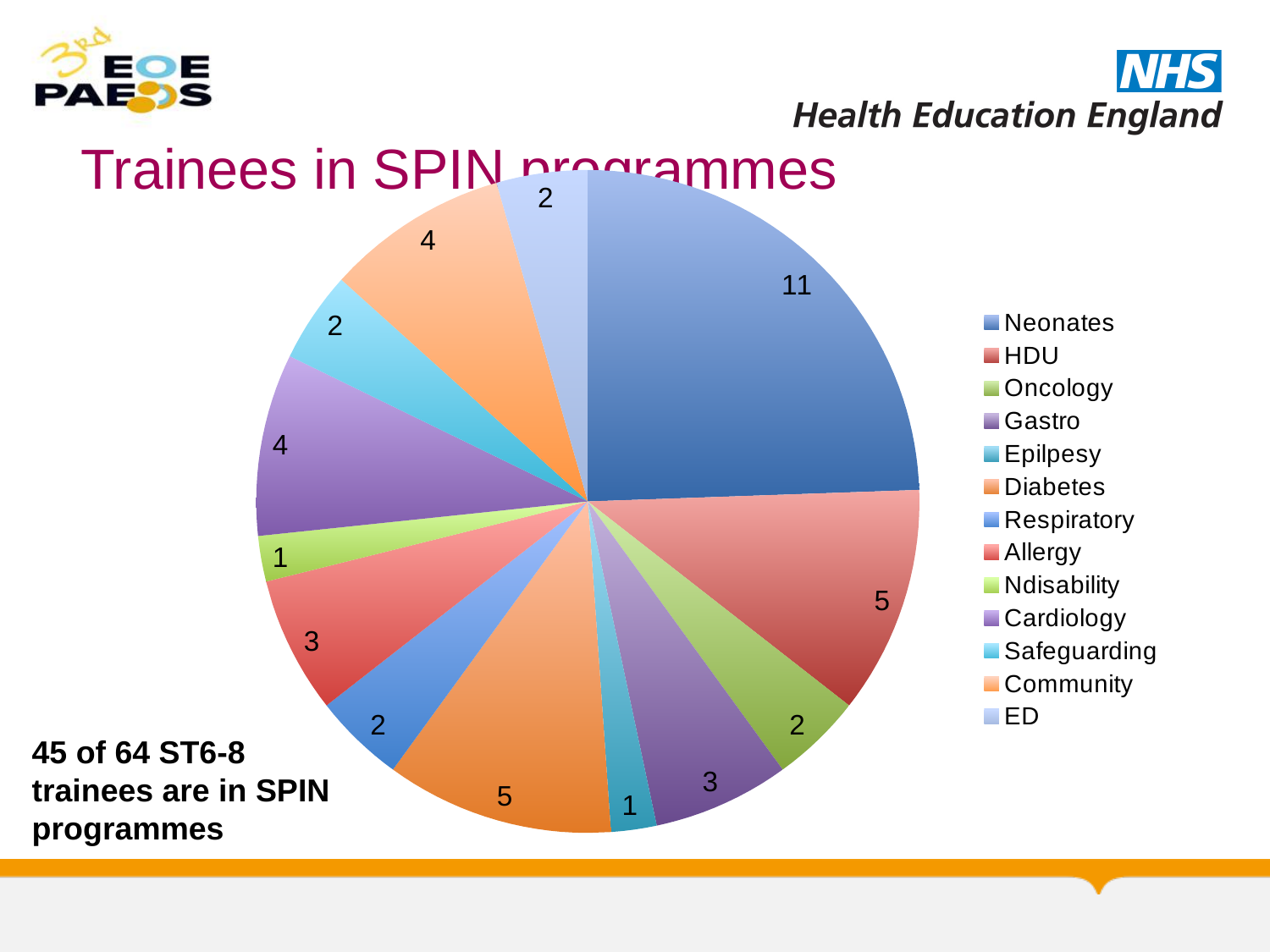
How many programmes (slices) are shown in the pie chart? 13 What type of chart is shown on the slide? pie chart What is the value shown for Epilpesy? 1 Which has more trainees, Gastro or Oncology? Gastro Which has more trainees, Community or Respiratory? Community How many trainees are in the Neonates SPIN programme? 11 What is the value shown for Cardiology? 4 What is the title of the chart? Trainees in SPIN programmes What is the total of all the slice values in the pie chart? 45 What is the difference between the Neonates value and the Diabetes value? 6 Which SPIN programme has the largest slice of the pie? Neonates What is the value shown for HDU? 5